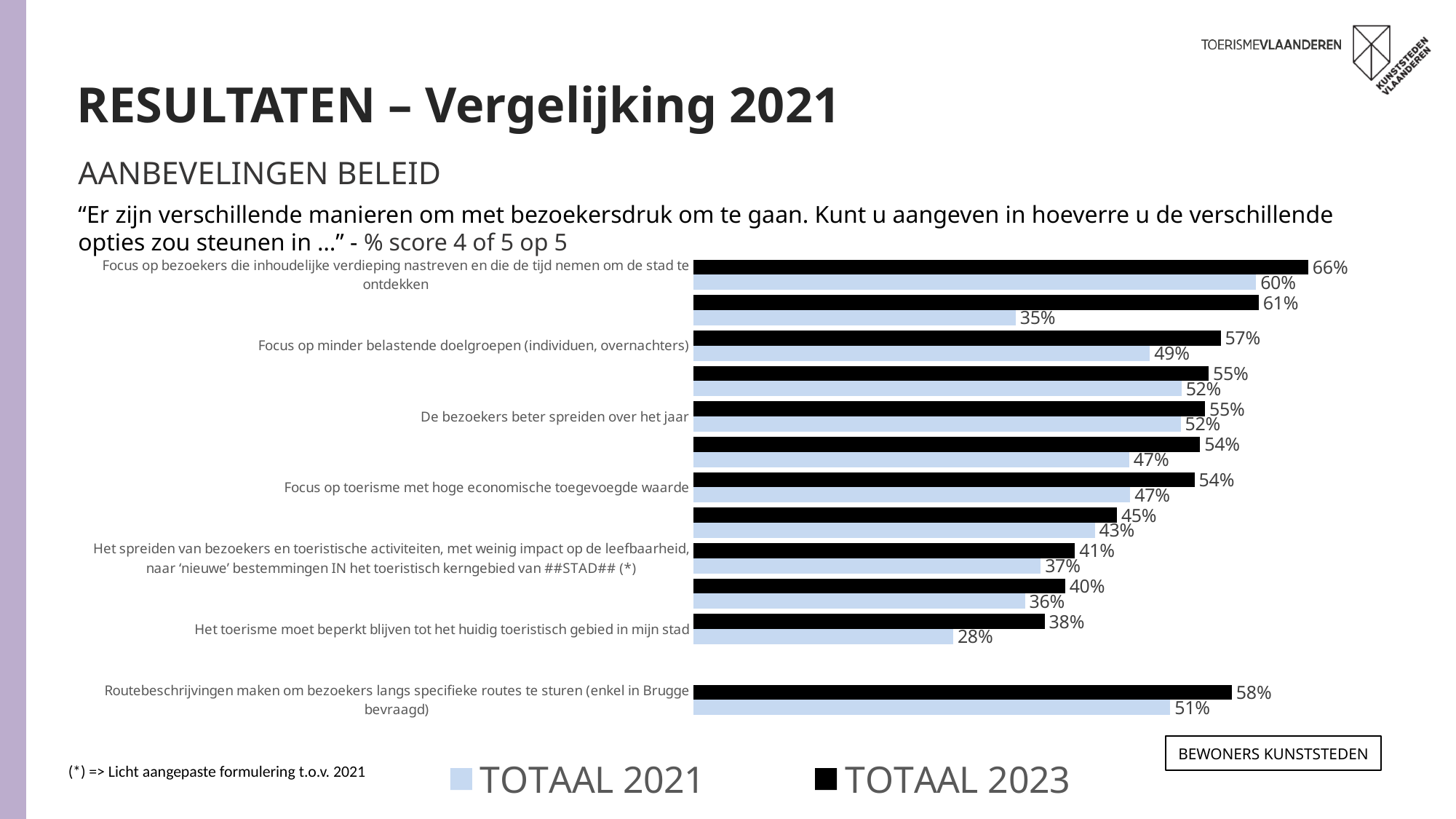
What is the TOTAAL 2023 value for 'Het toerisme moet beperkt blijven tot het huidig toeristisch gebied in mijn stad'? 38% What is the TOTAAL 2023 value for 'Routebeschrijvingen maken om bezoekers langs specifieke routes te sturen (enkel in Brugge bevraagd)'? 58% What type of chart is shown on the slide? bar chart Which category has the lowest TOTAAL 2021 value? Het toerisme moet beperkt blijven tot het huidig toeristisch gebied in mijn stad How many series does the legend list? 2 What is the difference between the TOTAAL 2023 and TOTAAL 2021 values for 'Focus op toerisme met hoge economische toegevoegde waarde'? 7% What is the TOTAAL 2021 value for 'Focus op minder belastende doelgroepen (individuen, overnachters)'? 49% Which category has the highest TOTAAL 2023 value? Focus op bezoekers die inhoudelijke verdieping nastreven en die de tijd nemen om de stad te ontdekken For 'De bezoekers beter spreiden over het jaar', which is larger: the TOTAAL 2021 value or the TOTAAL 2023 value? TOTAAL 2023 What is the difference between the TOTAAL 2023 and TOTAAL 2021 values for 'Het toerisme moet beperkt blijven tot het huidig toeristisch gebied in mijn stad'? 10% Which colour represents the TOTAAL 2021 series in the chart? light blue How many pairs of bars (categories) are plotted in the chart? 12